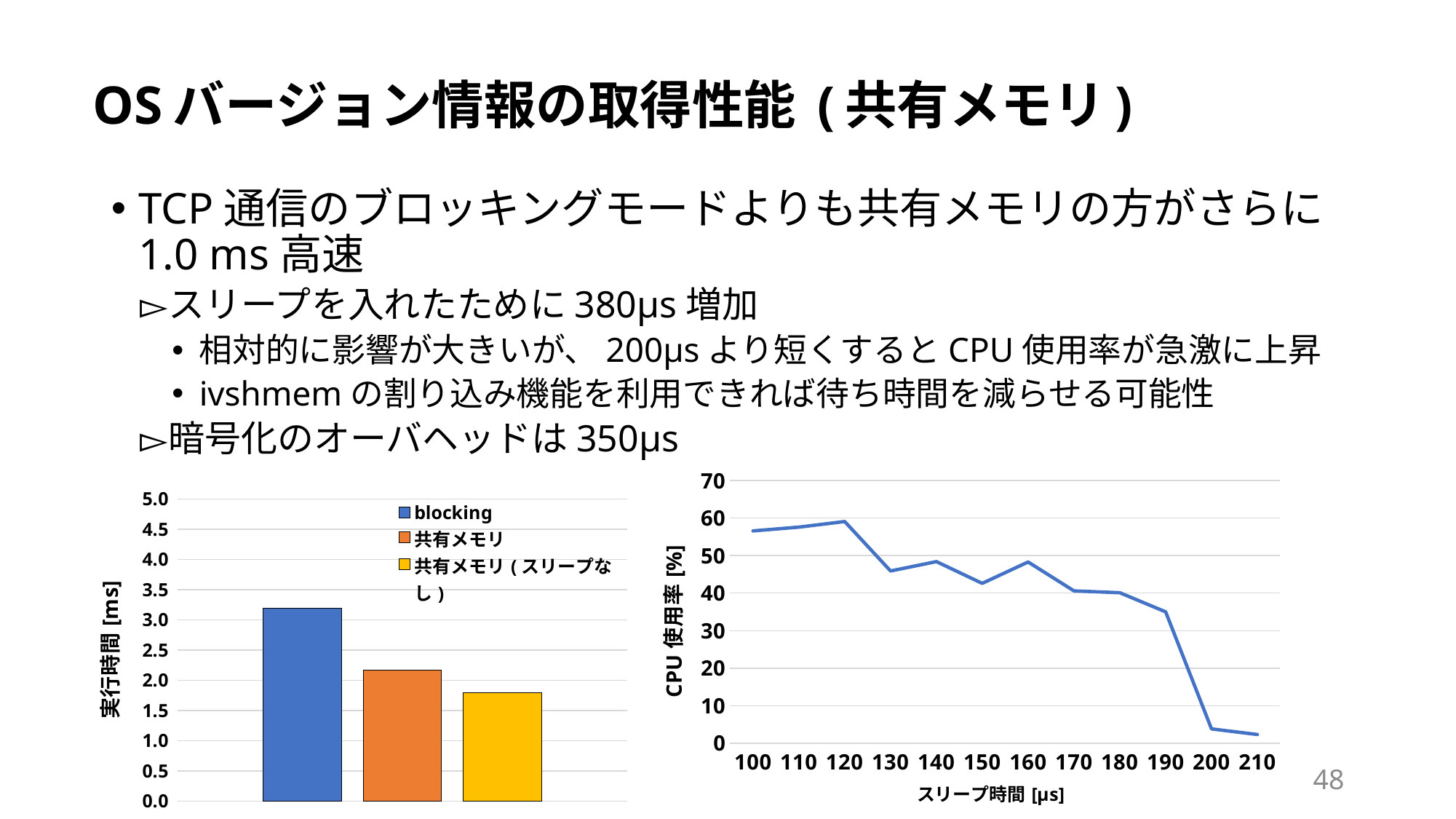
In the right chart, how many data points are plotted along the x axis? 12 In the left chart, which series has the lowest 実行時間? 共有メモリ ( スリープなし ) In the left chart, is the value for blocking greater or less than 3.0? greater In the left chart, which series has the highest 実行時間? blocking In the left chart, which is larger, the value for blocking or the value for 共有メモリ? blocking In the left chart, how many series does the legend list? 3 What kind of chart is the left chart (実行時間 [ms])? bar chart What kind of chart is the right chart (CPU 使用率 [%])? line chart In the left chart, is the value for 共有メモリ ( スリープなし ) greater or less than 2.0? less In the right chart, is the value at スリープ時間 200 greater or less than 10? less In the right chart, does CPU 使用率 generally rise or fall as スリープ時間 increases? fall In the right chart, which is larger, the value at スリープ時間 160 or at 170? 160